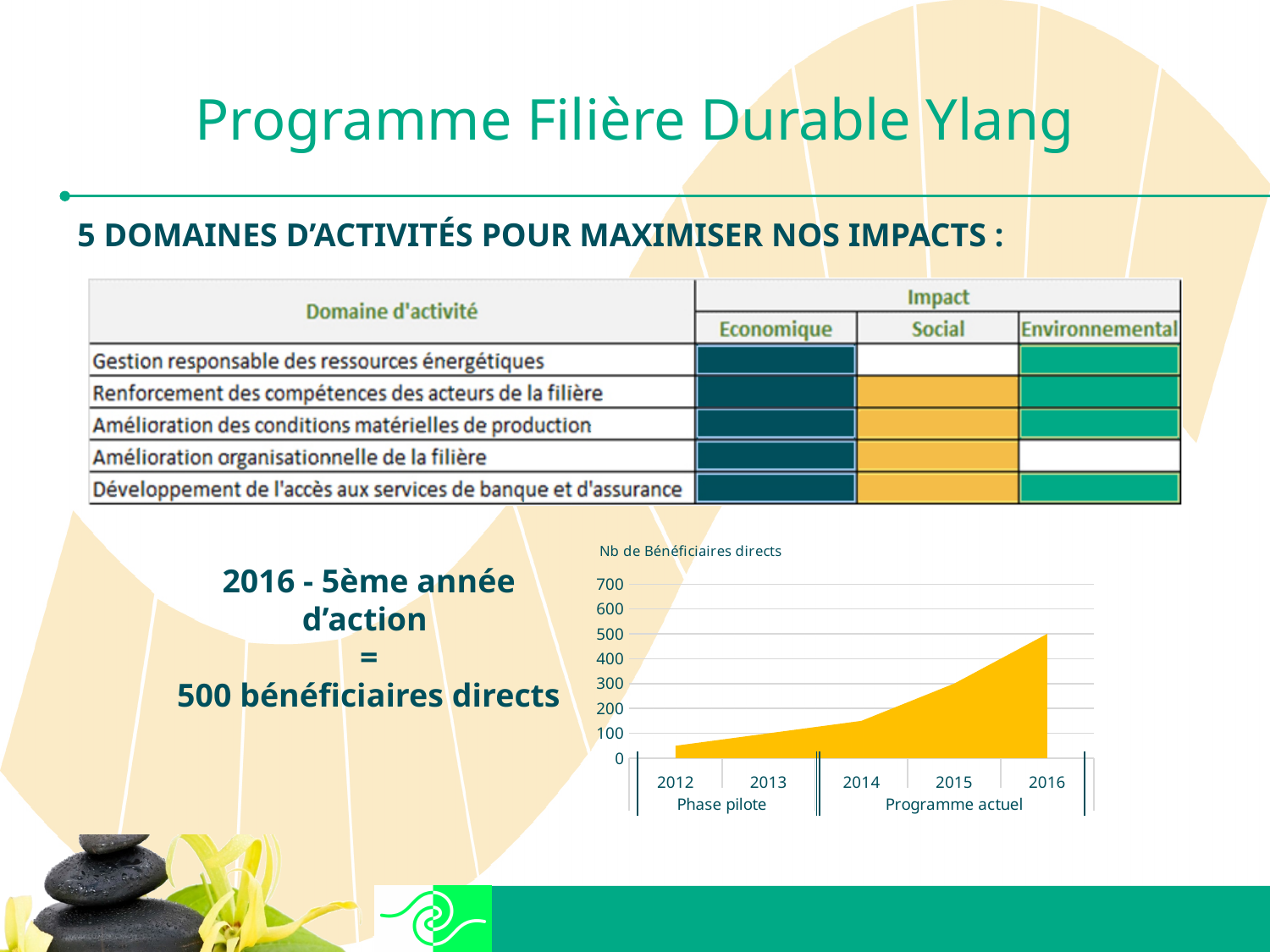
What is the number of direct beneficiaries in 2016? 500 Which year has the highest number of direct beneficiaries? 2016 Do the values rise or fall from 2012 to 2016? rise Is the value for 2015 greater or less than 200? greater What is the title of the chart? Nb de Bénéficiaires directs How many years are shown on the x axis of the chart? 5 Which year has the larger value, 2013 or 2015? 2015 Which year has the lowest number of direct beneficiaries? 2012 Is the value for 2014 greater or less than 200? less Which two phases are labelled under the x axis of the chart? Phase pilote and Programme actuel What kind of chart is shown on the slide? area chart Is the value for 2012 greater or less than 100? less